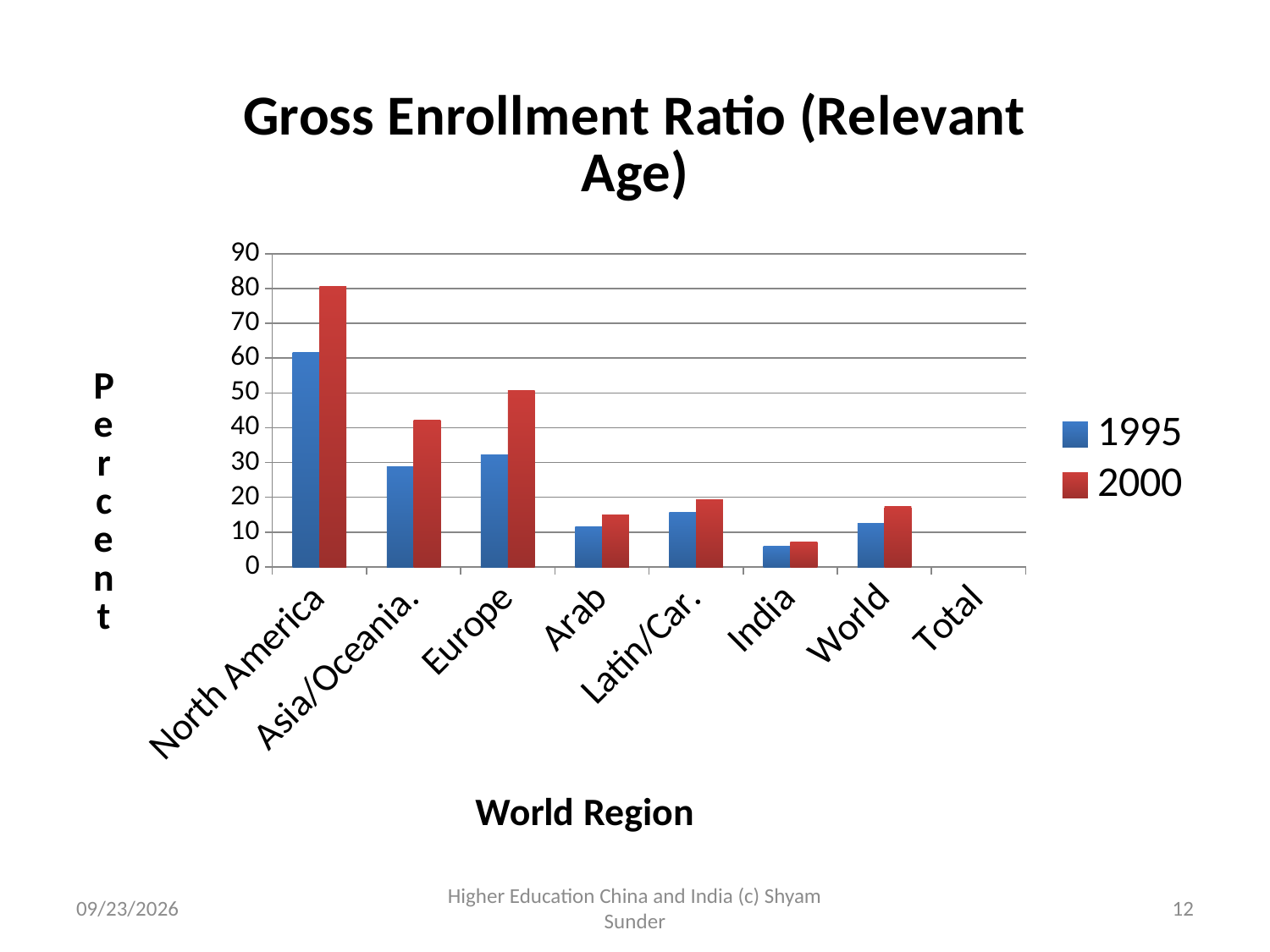
Which region has the larger 1995 value, Arab or Latin/Car.? Latin/Car. Is the value for India in 2000 greater or less than 10? less Which region has the highest value for 2000? North America Is the value for Asia/Oceania in 2000 greater or less than 40? greater How many series does the legend list? 2 What is the title of the chart? Gross Enrollment Ratio (Relevant Age) Is the value for Europe in 1995 greater or less than 30? greater Which region has the lowest value for 1995? India What kind of chart is shown on the slide? bar chart How many category labels are shown on the x axis? 8 Which is larger for Europe, the 1995 value or the 2000 value? 2000